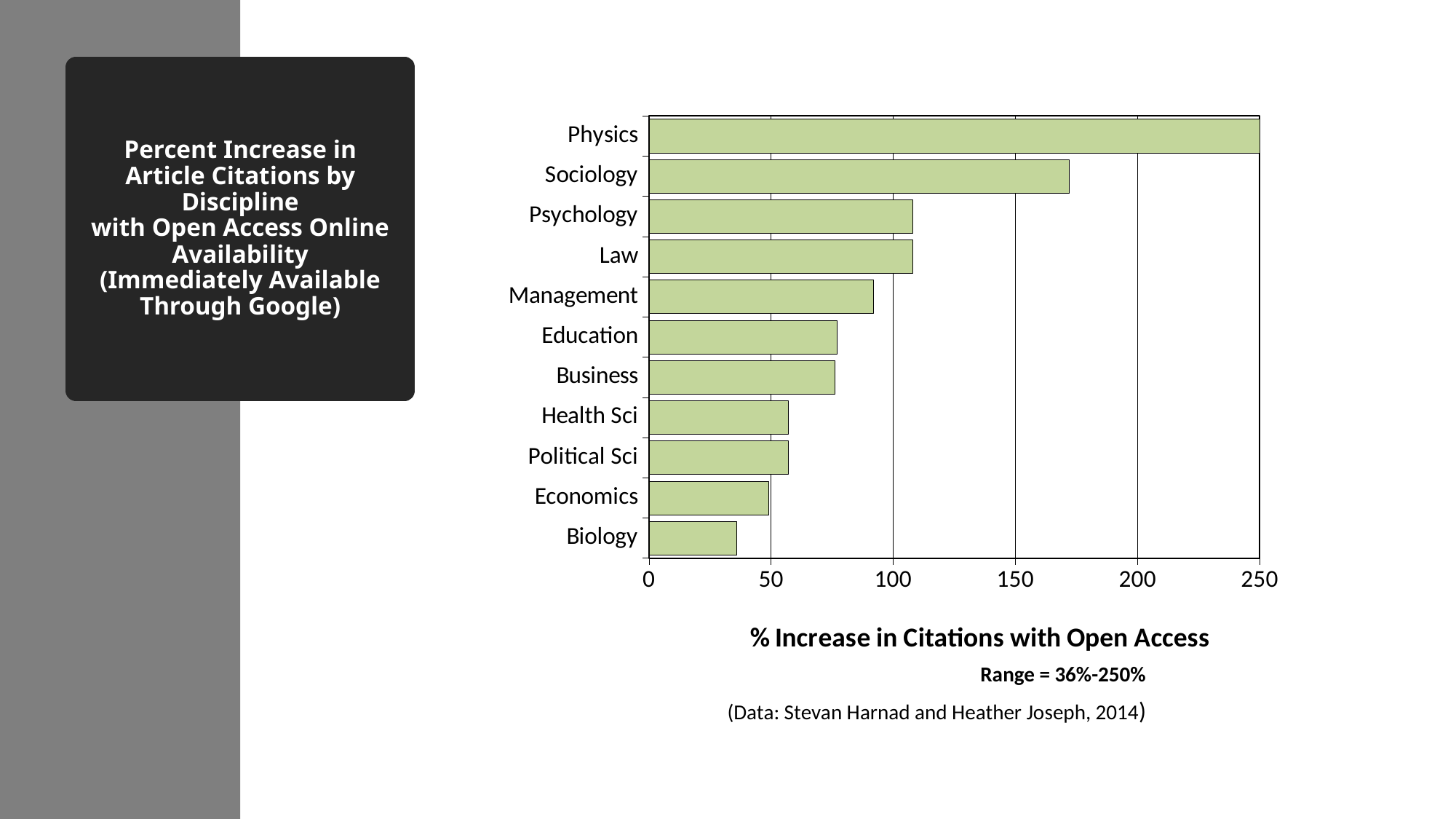
Is the value for Sociology greater or less than 150? greater Which has a larger value, Sociology or Psychology? Sociology Is the value for Management greater or less than 100? less Is the value for Education greater or less than 50? greater How many disciplines are plotted in the chart? 11 What is the value for Physics? 250 What is the title of the horizontal axis of the chart? % Increase in Citations with Open Access Which discipline has the lowest percent increase in citations? Biology What kind of chart is shown on the slide? bar chart Which has a larger value, Management or Business? Management Which discipline has the highest percent increase in citations? Physics